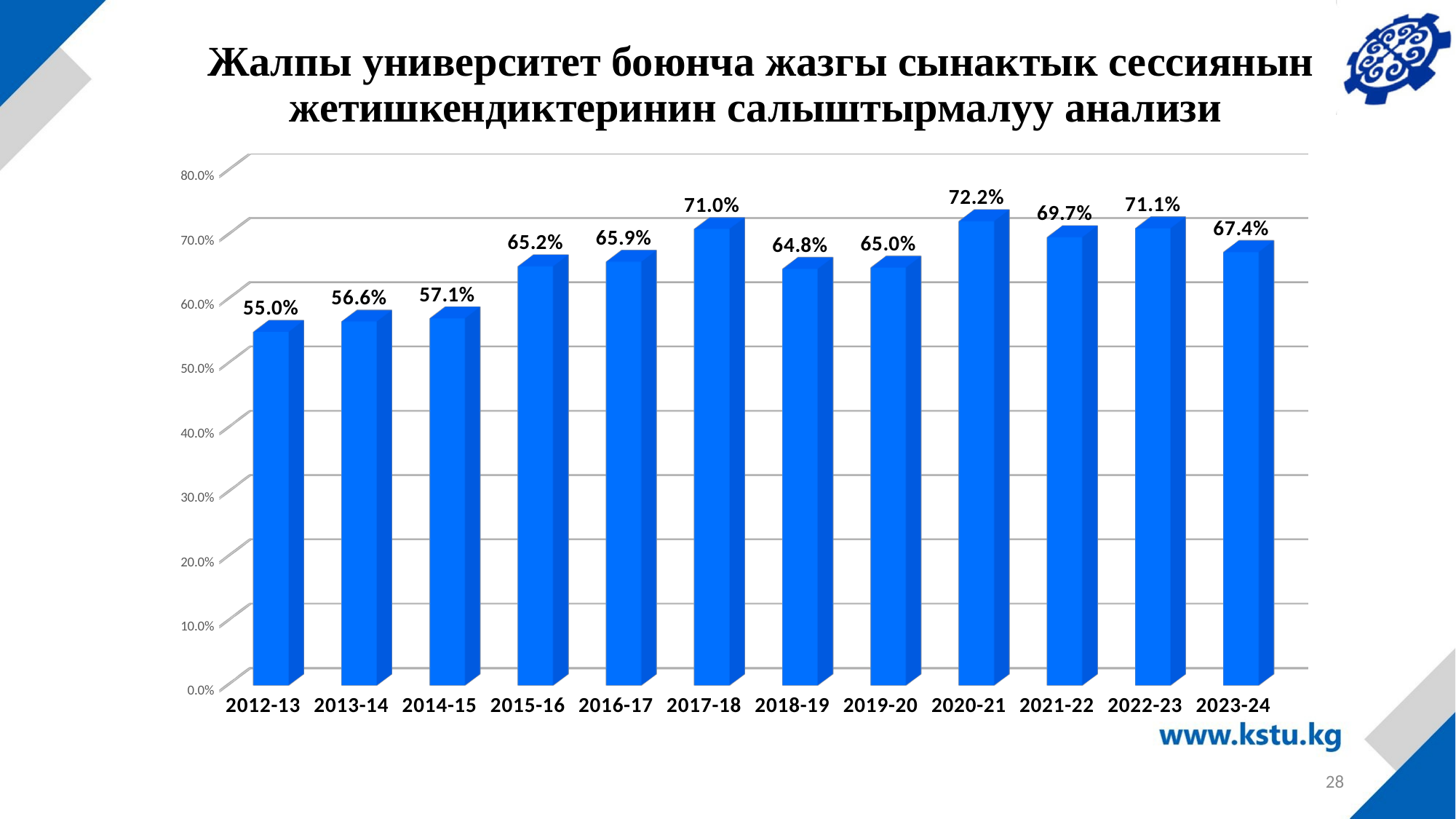
What is the value for 2012-13? 55.0% Which academic year has the lowest value? 2012-13 Is the value for 2021-22 greater or less than 60.0%? greater Which is larger, the value for 2015-16 or the value for 2018-19? 2015-16 What is the value for 2023-24? 67.4% What kind of chart is shown on the slide? bar chart Which academic year has the highest value? 2020-21 What is the difference between the values for 2022-23 and 2023-24? 3.7% What is the value for 2017-18? 71.0% What is the difference between the values for 2020-21 and 2012-13? 17.2% Do the values generally rise or fall from 2012-13 to 2017-18? rise How many academic years are shown on the x axis? 12